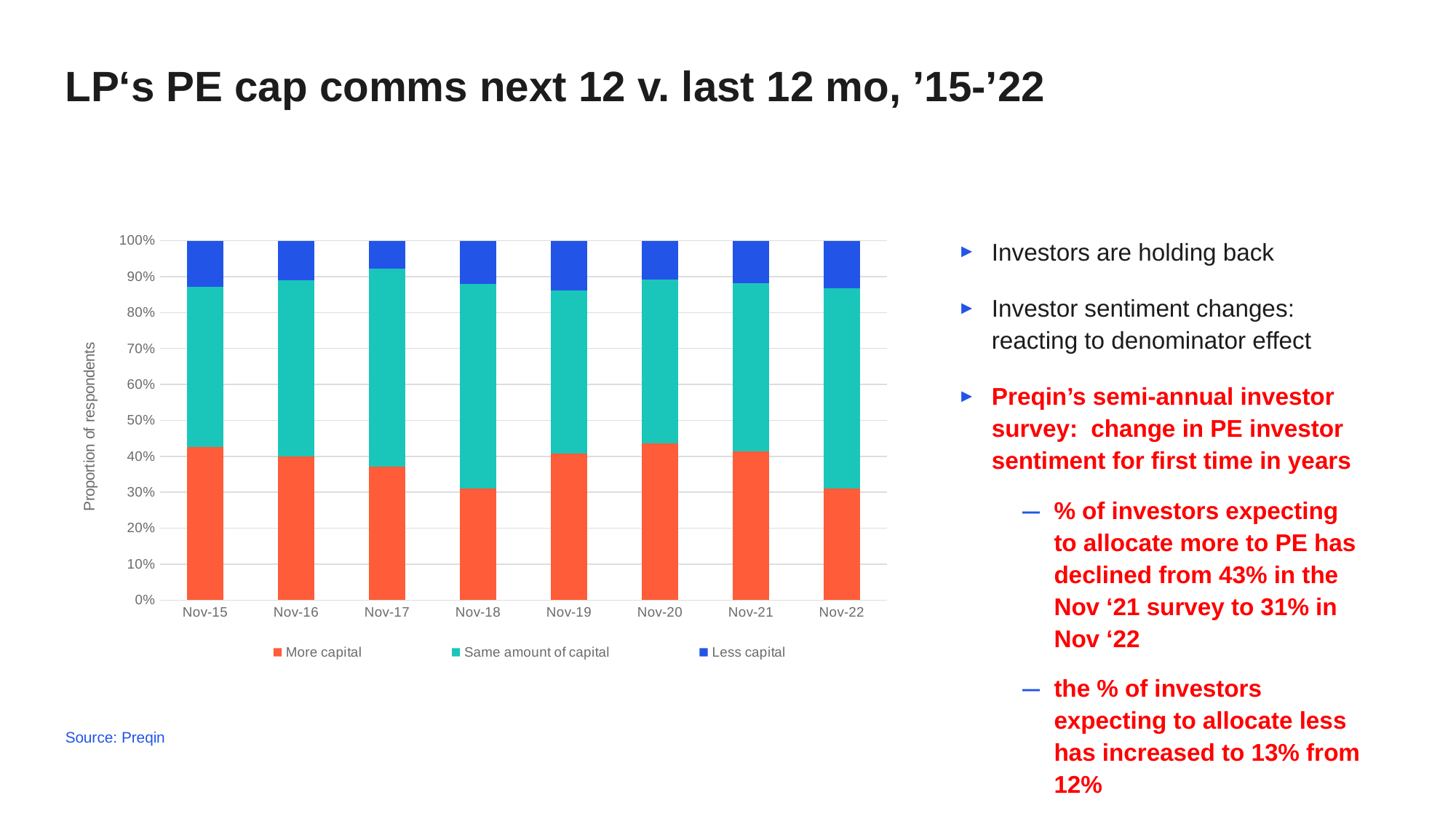
Is the 'Less capital' share for Nov-17 greater or less than 10%? less What is the label on the y axis? Proportion of respondents What kind of chart is shown on the slide? Stacked bar chart Which series is shown in orange in the legend? More capital How many series does the legend list? 3 Is the 'More capital' value for Nov-20 greater or less than 40%? greater Does the 'More capital' share rise or fall from Nov-20 to Nov-22? Fall Which survey date has the smallest 'Less capital' segment? Nov-17 Which is larger, the 'More capital' value for Nov-15 or for Nov-17? Nov-15 How many survey dates (categories) are shown on the x axis? 8 Is the 'More capital' value for Nov-17 greater or less than 40%? less